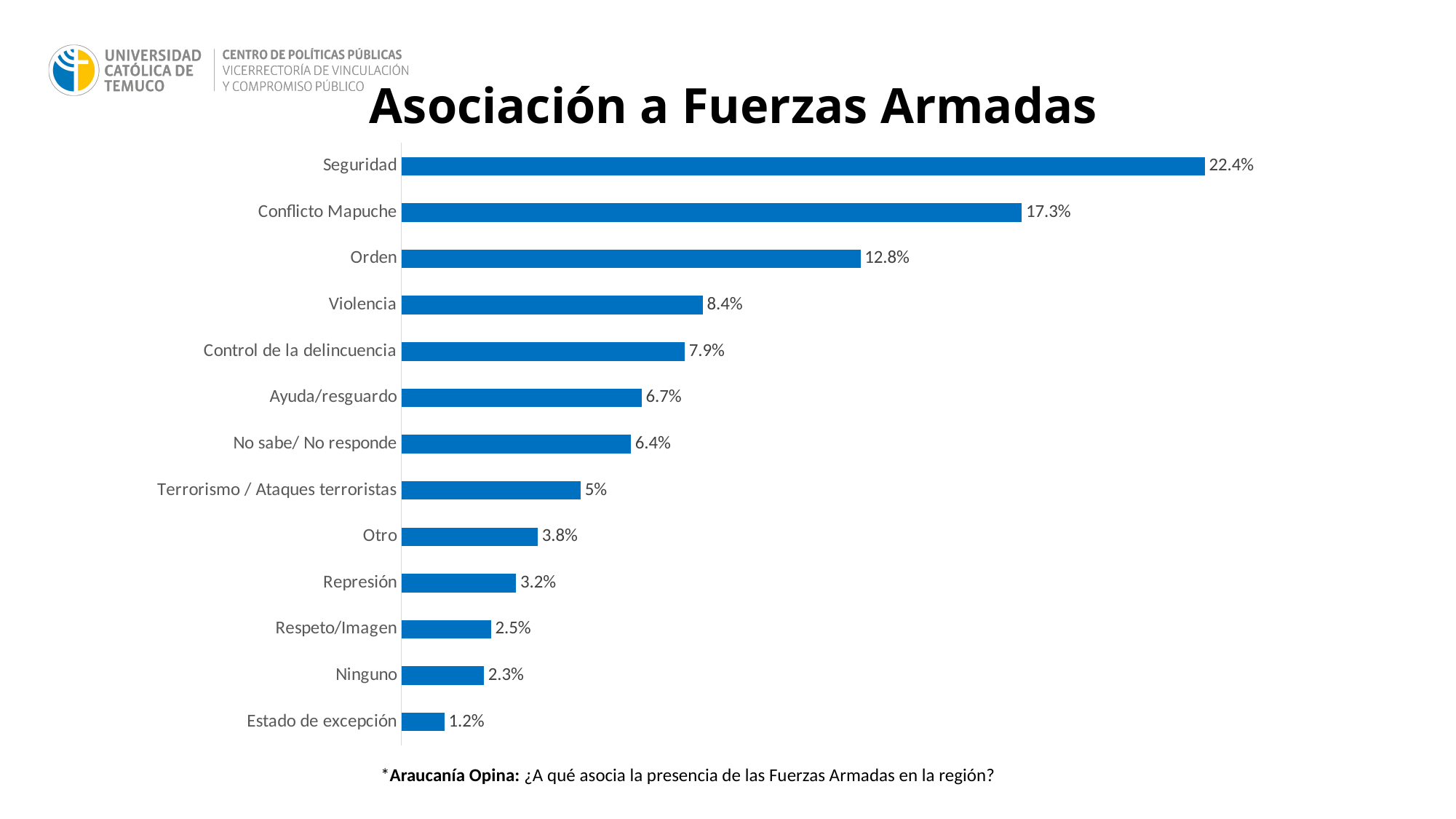
What is the value for Conflicto Mapuche? 17.3% What is the value for Estado de excepción? 1.2% Which is larger, Violencia or Control de la delincuencia? Violencia How many categories are shown in the chart? 13 Which category has the highest value? Seguridad What is the value for Seguridad? 22.4% What kind of chart is this? Bar chart Which category has the lowest value? Estado de excepción What is the difference between Orden and Violencia? 4.4% What is the difference between Seguridad and Conflicto Mapuche? 5.1% What is the title of the chart? Asociación a Fuerzas Armadas What is the value for Terrorismo / Ataques terroristas? 5%